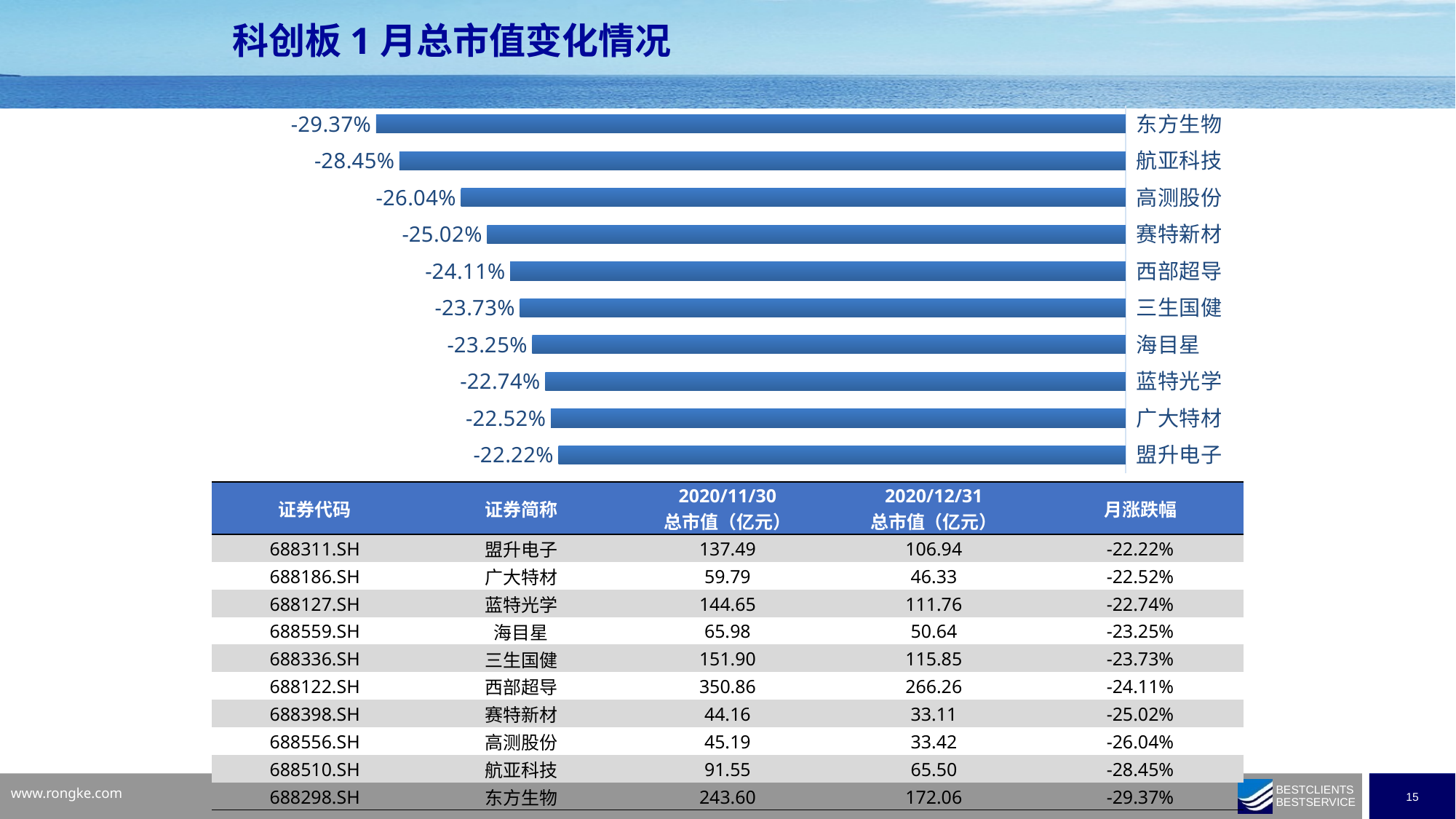
What is the value shown for 西部超导 in the bar chart? -24.11% In the bar chart, which company shows a larger decline, 赛特新材 or 三生国健? 赛特新材 What is the value shown for 东方生物 in the bar chart? -29.37% Which company in the bar chart has the smallest decline (the least negative value)? 盟升电子 Which company in the bar chart has the largest decline (the most negative value)? 东方生物 What is the title of the slide containing the chart? 科创板 1 月总市值变化情况 What type of chart is shown on the slide? Bar chart What is the value shown for 海目星 in the bar chart? -23.25% How many companies are shown in the bar chart? 10 What is the difference in percentage points between the values for 东方生物 and 盟升电子 in the bar chart? 7.15 percentage points What is the value shown for 盟升电子 in the bar chart? -22.22% What is the difference in percentage points between the values for 航亚科技 and 高测股份 in the bar chart? 2.41 percentage points